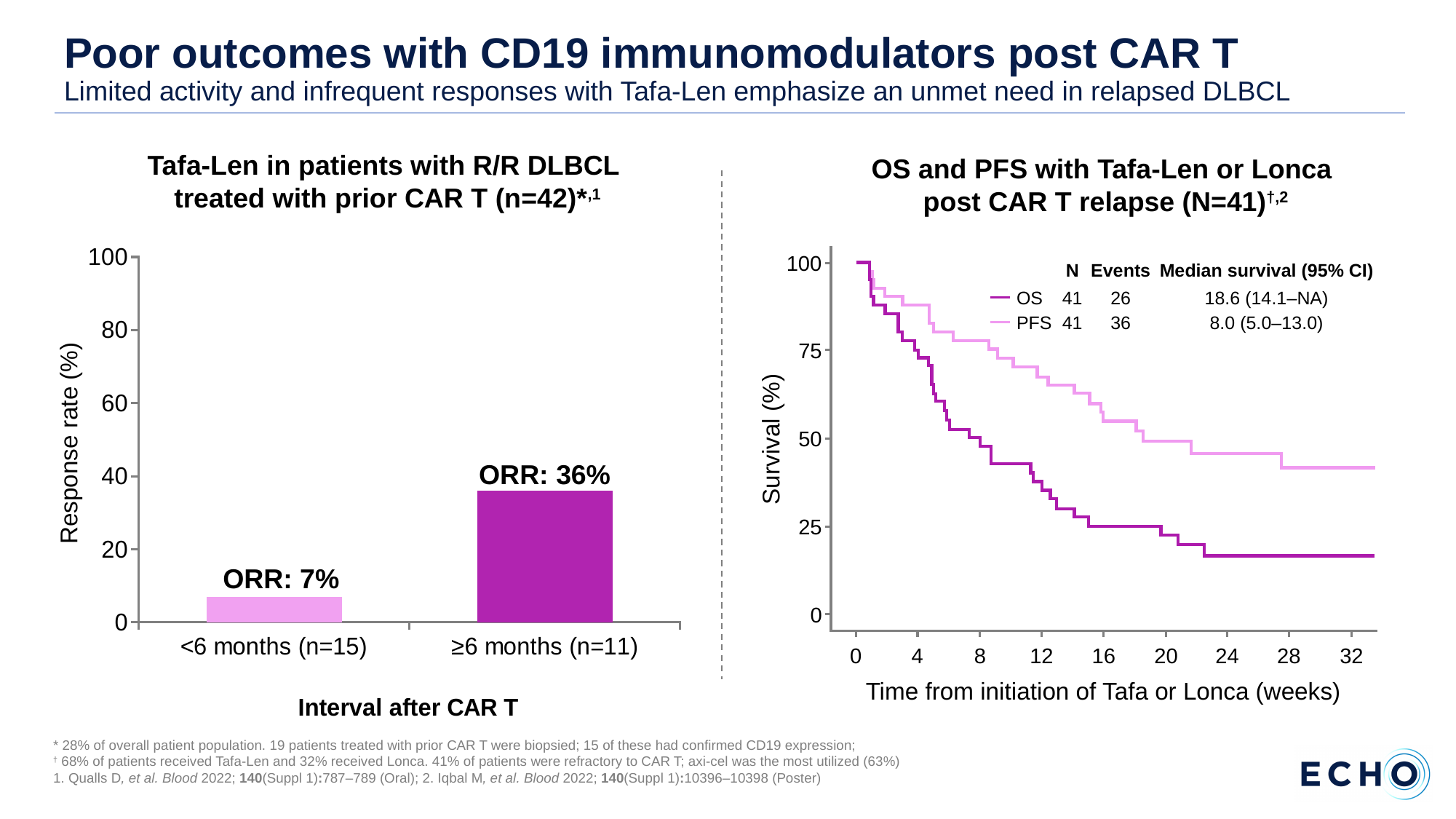
In the right chart (OS and PFS with Tafa-Len or Lonca post CAR T relapse), do the survival curves rise or fall over time? Fall In the left chart (Tafa-Len in patients with R/R DLBCL treated with prior CAR T), how many bars are plotted? 2 In the left chart (Tafa-Len in patients with R/R DLBCL treated with prior CAR T), what is the ORR for the ≥6 months (n=11) group? 36% In the right chart (OS and PFS with Tafa-Len or Lonca post CAR T relapse), how many series does the legend list? 2 In the left chart (Tafa-Len in patients with R/R DLBCL treated with prior CAR T), which interval group has the higher response rate? ≥6 months (n=11) In the left chart (Tafa-Len in patients with R/R DLBCL treated with prior CAR T), what is the ORR for the <6 months (n=15) group? 7% What kind of chart is the left chart (Tafa-Len in patients with R/R DLBCL treated with prior CAR T)? Bar chart In the right chart (OS and PFS with Tafa-Len or Lonca post CAR T relapse), what is the median survival for OS? 18.6 (14.1–NA) In the right chart (OS and PFS with Tafa-Len or Lonca post CAR T relapse), how many events were recorded for PFS? 36 In the left chart (Tafa-Len in patients with R/R DLBCL treated with prior CAR T), what is the label of the x axis? Interval after CAR T In the right chart (OS and PFS with Tafa-Len or Lonca post CAR T relapse), is the OS survival at 32 weeks greater or less than 25%? less In the left chart (Tafa-Len in patients with R/R DLBCL treated with prior CAR T), what is the difference in ORR between the ≥6 months and <6 months groups? 29%